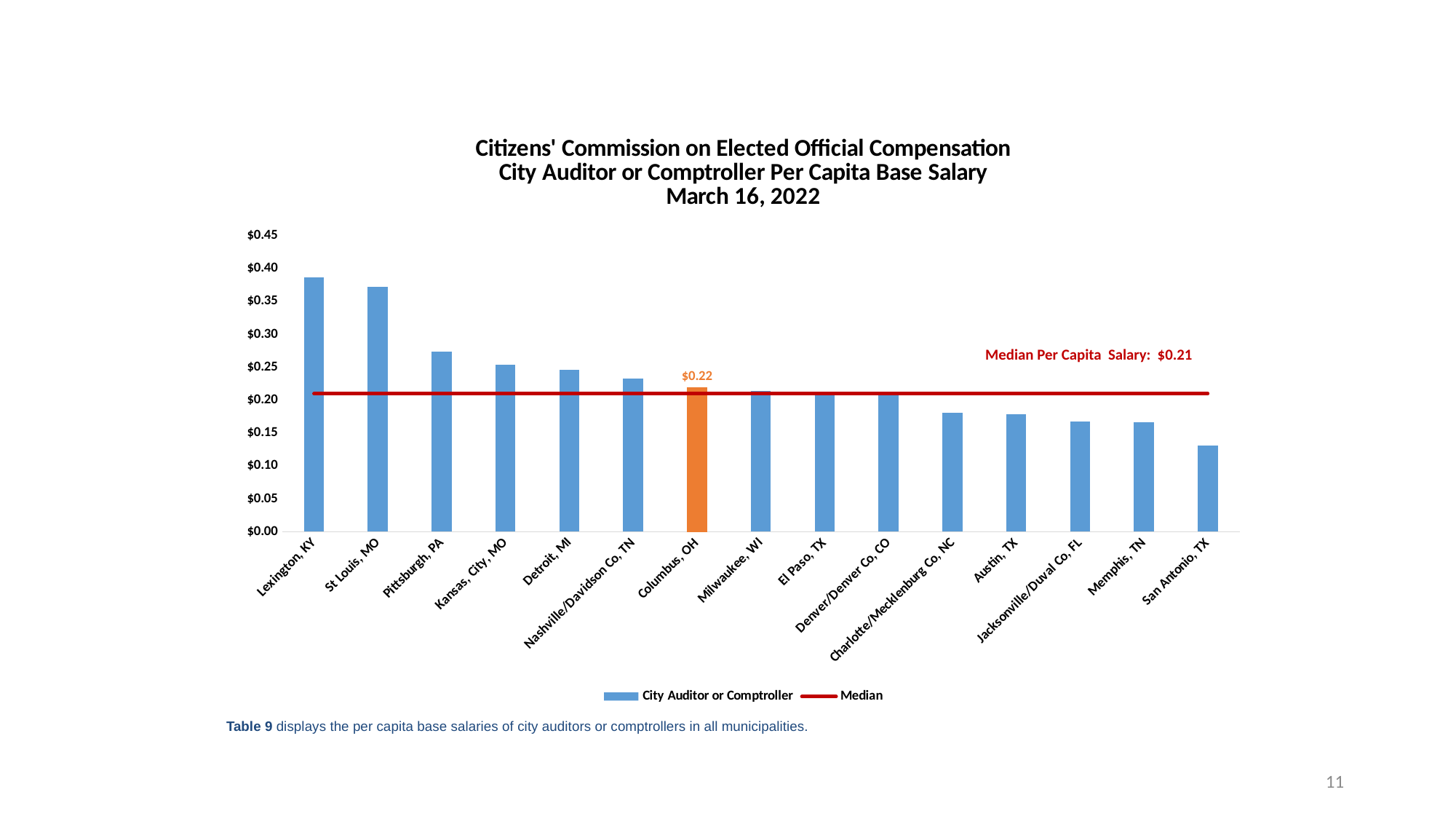
Do the bar values rise or fall moving from left to right along the x axis? Fall How many cities are shown on the x axis of the chart? 15 How many entries does the chart legend list? 2 Which city has the lowest per capita base salary for city auditor or comptroller? San Antonio, TX What type of chart is shown on the slide? Bar chart Is the value for Lexington, KY greater or less than $0.35? greater What is the median per capita salary shown on the chart? $0.21 Is the value for Charlotte/Mecklenburg Co, NC greater or less than $0.20? less What is the per capita base salary value labeled for Columbus, OH? $0.22 Is the value for San Antonio, TX greater or less than $0.15? less Which city has the highest per capita base salary for city auditor or comptroller? Lexington, KY Which has a higher per capita base salary, Pittsburgh, PA or Kansas City, MO? Pittsburgh, PA